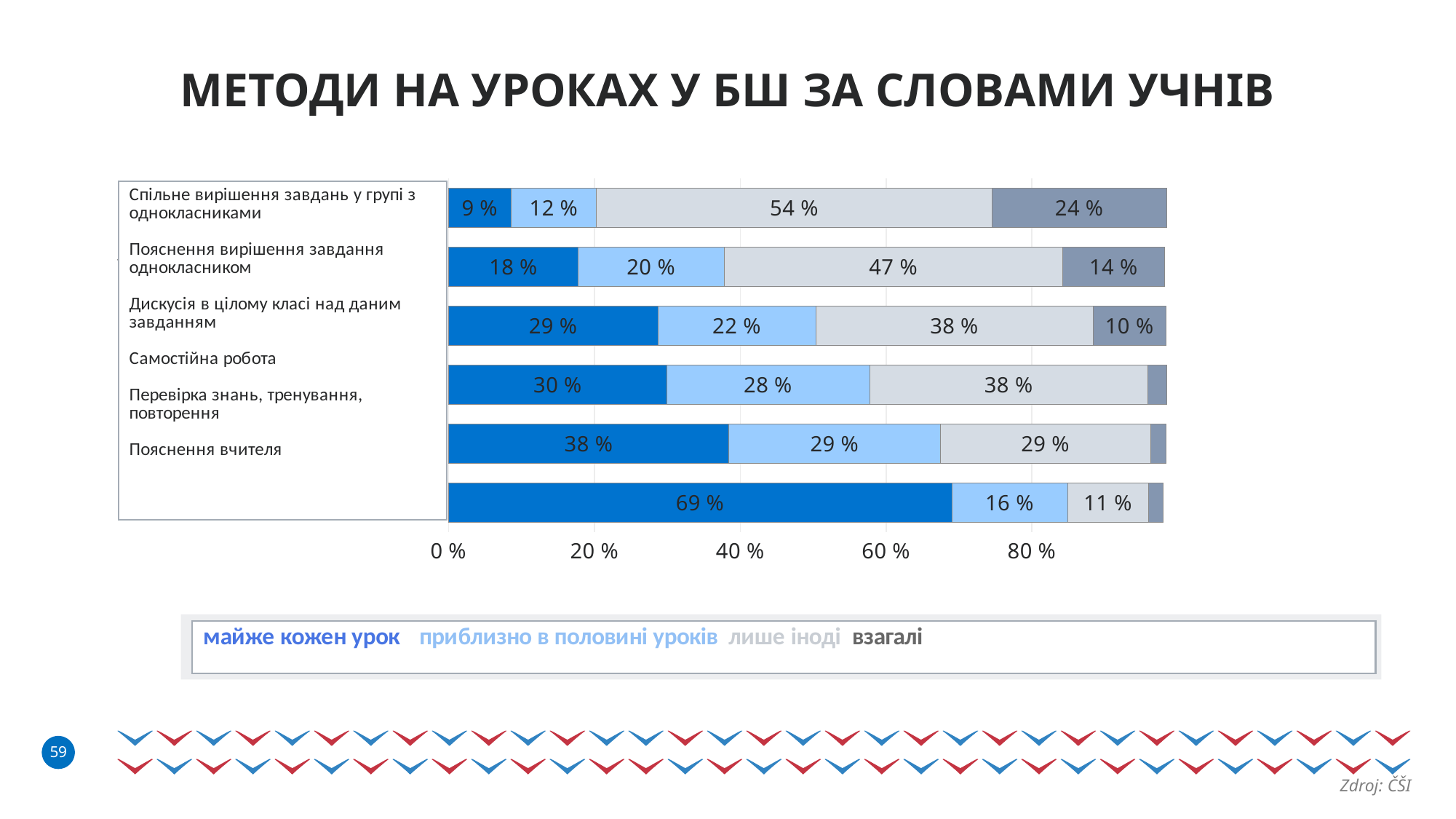
What is the value of "майже кожен урок" for "Пояснення вчителя"? 69 % Which category has the highest value for "майже кожен урок"? Пояснення вчителя What is the value of "лише іноді" for "Дискусія в цілому класі над даним завданням"? 38 % Which category has the lowest value for "майже кожен урок"? Спільне вирішення завдань у групі з однокласниками Which has a larger "лише іноді" value: "Спільне вирішення завдань у групі з однокласниками" or "Пояснення вирішення завдання однокласником"? Спільне вирішення завдань у групі з однокласниками What is the difference between the "майже кожен урок" values for "Пояснення вчителя" and "Перевірка знань, тренування, повторення"? 31 % How many series does the legend list? 4 What is the value of "приблизно в половині уроків" for "Самостійна робота"? 28 % How many categories (teaching methods) are shown in the chart? 6 What kind of chart is shown on the slide? Stacked bar chart Which legend entry is shown in the darkest blue colour? майже кожен урок What is the value of "взагалі" for "Спільне вирішення завдань у групі з однокласниками"? 24 %